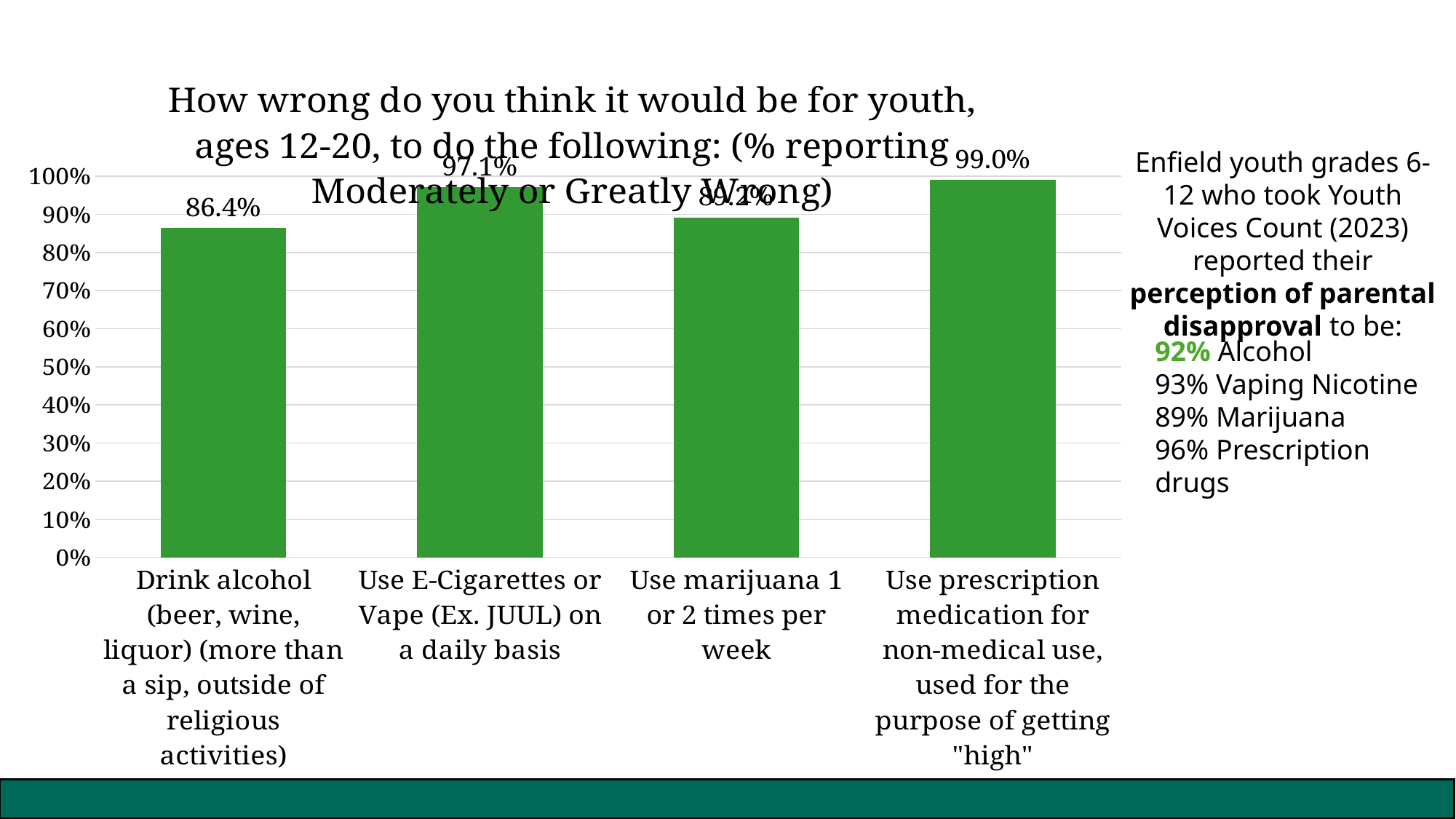
What is the difference in percentage points between the E-Cigarettes/Vape bar and the drink alcohol bar? 10.7 percentage points What colour are the bars in the chart? Green Which is larger: the value for using E-Cigarettes or Vape daily, or the value for drinking alcohol? Use E-Cigarettes or Vape (Ex. JUUL) on a daily basis How many behaviors (bars) are shown in the chart? 4 What percentage of youth reported it would be moderately or greatly wrong to drink alcohol (beer, wine, liquor)? 86.4% What is the value for 'Use E-Cigarettes or Vape (Ex. JUUL) on a daily basis'? 97.1% Which behavior has the lowest percentage reporting it would be moderately or greatly wrong? Drink alcohol (beer, wine, liquor) What type of chart is shown on the slide? Bar chart What is the difference in percentage points between the prescription medication bar and the drink alcohol bar? 12.6 percentage points Which behavior has the highest percentage reporting it would be moderately or greatly wrong? Use prescription medication for non-medical use, used for the purpose of getting "high" Is the value for 'Use marijuana 1 or 2 times per week' greater or less than 80%? greater What is the value for using prescription medication for non-medical use to get 'high'? 99.0%